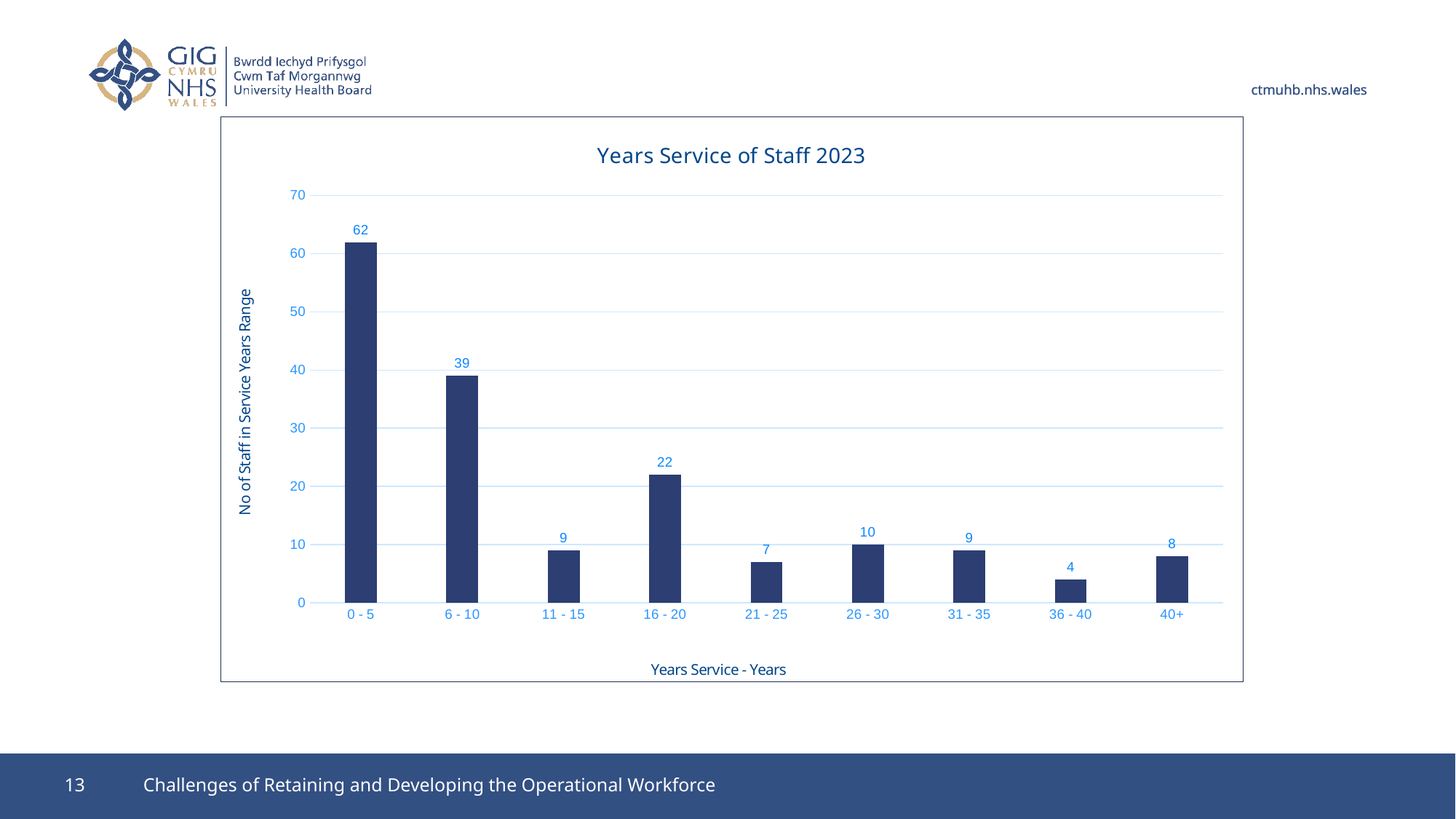
Is the value for the 6 - 10 range greater or less than 30? greater What is the number of staff in the 16 - 20 years service range? 22 How many years service ranges are shown on the x axis? 9 What is the label of the y axis? No of Staff in Service Years Range Which years service range has the highest number of staff? 0 - 5 What kind of chart is shown on the slide? Bar chart What is the number of staff in the 36 - 40 years service range? 4 Which has more staff, the 26 - 30 range or the 21 - 25 range? 26 - 30 Which years service range has the lowest number of staff? 36 - 40 What is the difference in staff numbers between the 0 - 5 and 6 - 10 ranges? 23 What is the number of staff in the 0 - 5 years service range? 62 What is the title of the chart? Years Service of Staff 2023